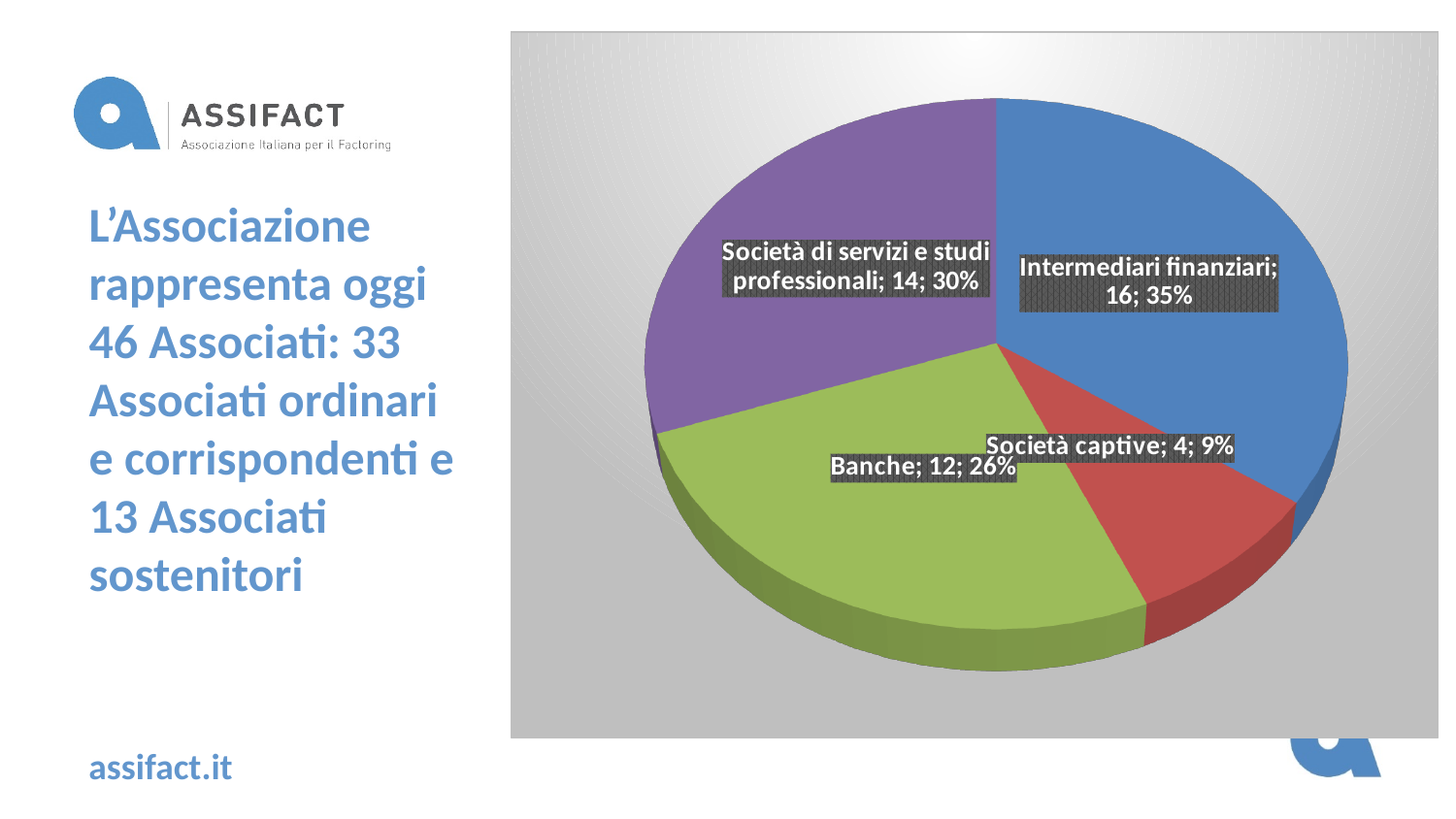
What share of the pie does Intermediari finanziari represent? 35% What kind of chart is shown on the slide? Pie chart Which category has the largest slice? Intermediari finanziari What is the value for Società captive? 4 What is the value for Banche? 12 What is the difference between the values for Intermediari finanziari and Banche? 4 Which category has the smallest slice? Società captive Which is larger, the value for Società di servizi e studi professionali or the value for Banche? Società di servizi e studi professionali What is the value for Intermediari finanziari? 16 What is the value for Società di servizi e studi professionali? 14 What share of the pie does Banche represent? 26% How many slices does the pie chart have? 4